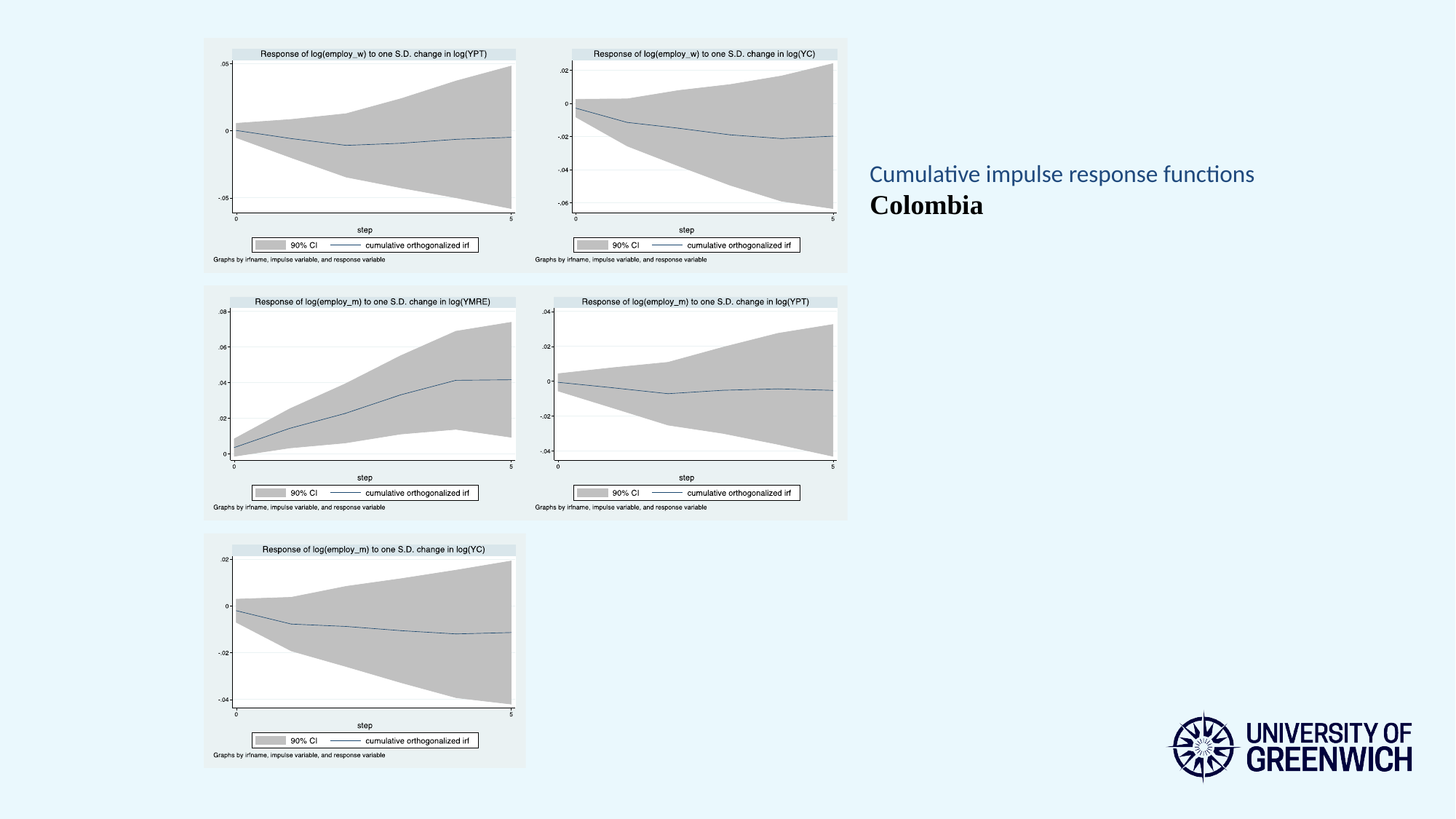
What is the x-axis label of the chart "Response of log(employ_m) to one S.D. change in log(YPT)"? step In the chart "Response of log(employ_m) to one S.D. change in log(YMRE)", does the cumulative orthogonalized irf rise or fall from step 0 to step 5? rise How many charts are shown on the slide? 5 How many entries does the legend of the chart "Response of log(employ_w) to one S.D. change in log(YPT)" list? 2 According to the legend of the chart "Response of log(employ_m) to one S.D. change in log(YC)", what does the grey shaded area represent? 90% CI In the chart "Response of log(employ_m) to one S.D. change in log(YC)", is the cumulative orthogonalized irf at step 5 greater or less than -.02? greater In the chart "Response of log(employ_w) to one S.D. change in log(YC)", does the cumulative orthogonalized irf rise or fall from step 0 to step 5? fall In the chart "Response of log(employ_m) to one S.D. change in log(YMRE)", is the cumulative orthogonalized irf at step 0 greater or less than .02? less In the chart "Response of log(employ_w) to one S.D. change in log(YC)", is the cumulative orthogonalized irf at step 5 greater or less than 0? less In the chart "Response of log(employ_m) to one S.D. change in log(YC)", does the cumulative orthogonalized irf rise or fall from step 0 to step 5? fall What kind of chart is "Response of log(employ_m) to one S.D. change in log(YMRE)"? line chart